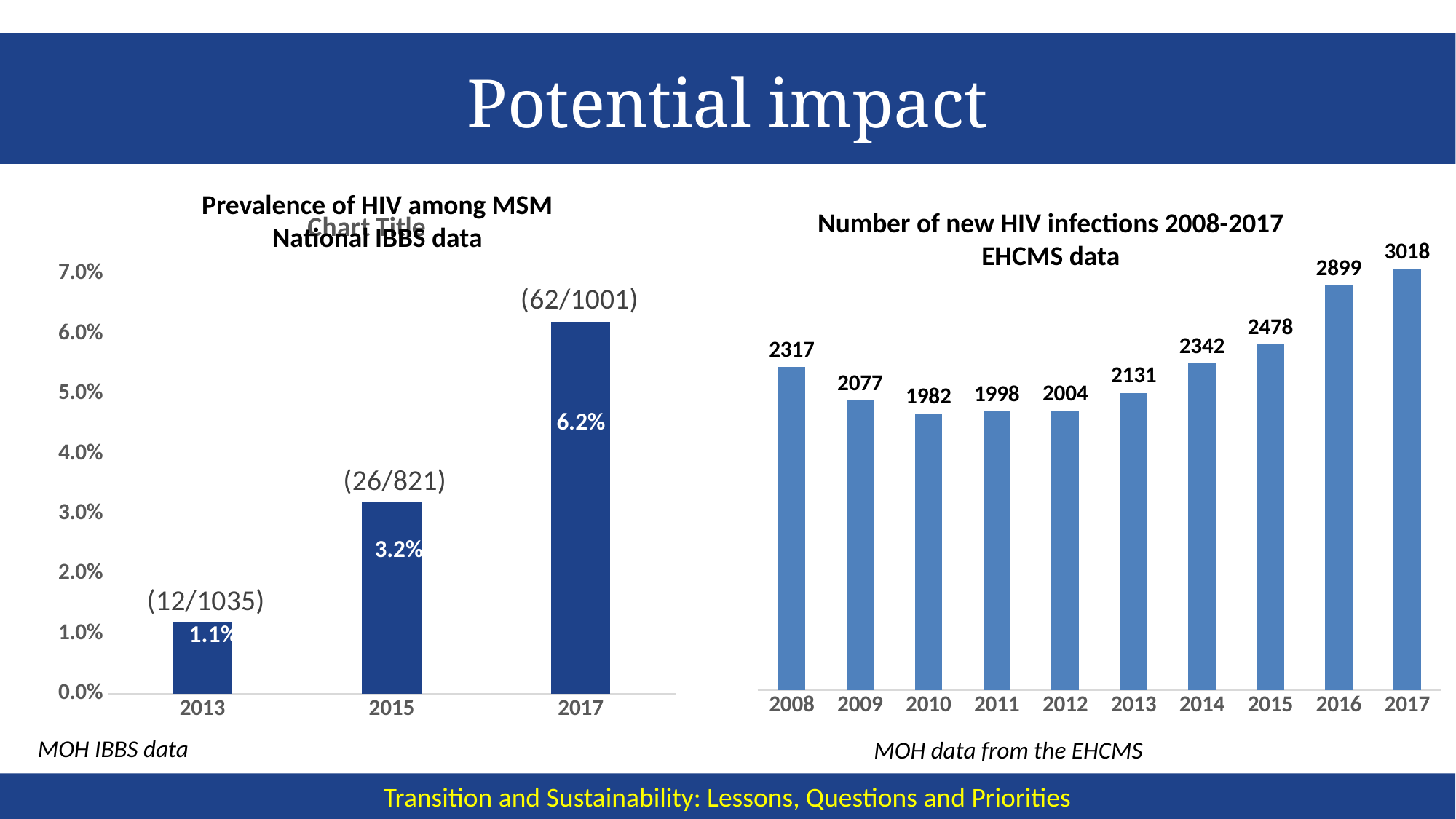
What type of chart is the 'Number of new HIV infections 2008-2017' chart? bar chart In the 'Prevalence of HIV among MSM' chart, do the values rise or fall from 2013 to 2017? rise In the 'Prevalence of HIV among MSM' chart, what fraction is shown above the 2015 bar? (26/821) In the 'Prevalence of HIV among MSM' chart, how many years are plotted? 3 In the 'Number of new HIV infections 2008-2017' chart, what is the value for 2016? 2899 In the 'Number of new HIV infections 2008-2017' chart, which year has the highest number of new infections? 2017 In the 'Number of new HIV infections 2008-2017' chart, what is the difference between the 2017 and 2008 values? 701 In the 'Prevalence of HIV among MSM' chart, what is the prevalence for 2017? 6.2% In the 'Number of new HIV infections 2008-2017' chart, which year has the lowest number of new infections? 2010 In the 'Number of new HIV infections 2008-2017' chart, which is larger, the value for 2008 or the value for 2013? 2008 In the 'Number of new HIV infections 2008-2017' chart, what is the value for 2010? 1982 In the 'Prevalence of HIV among MSM' chart, what is the prevalence for 2013? 1.1%